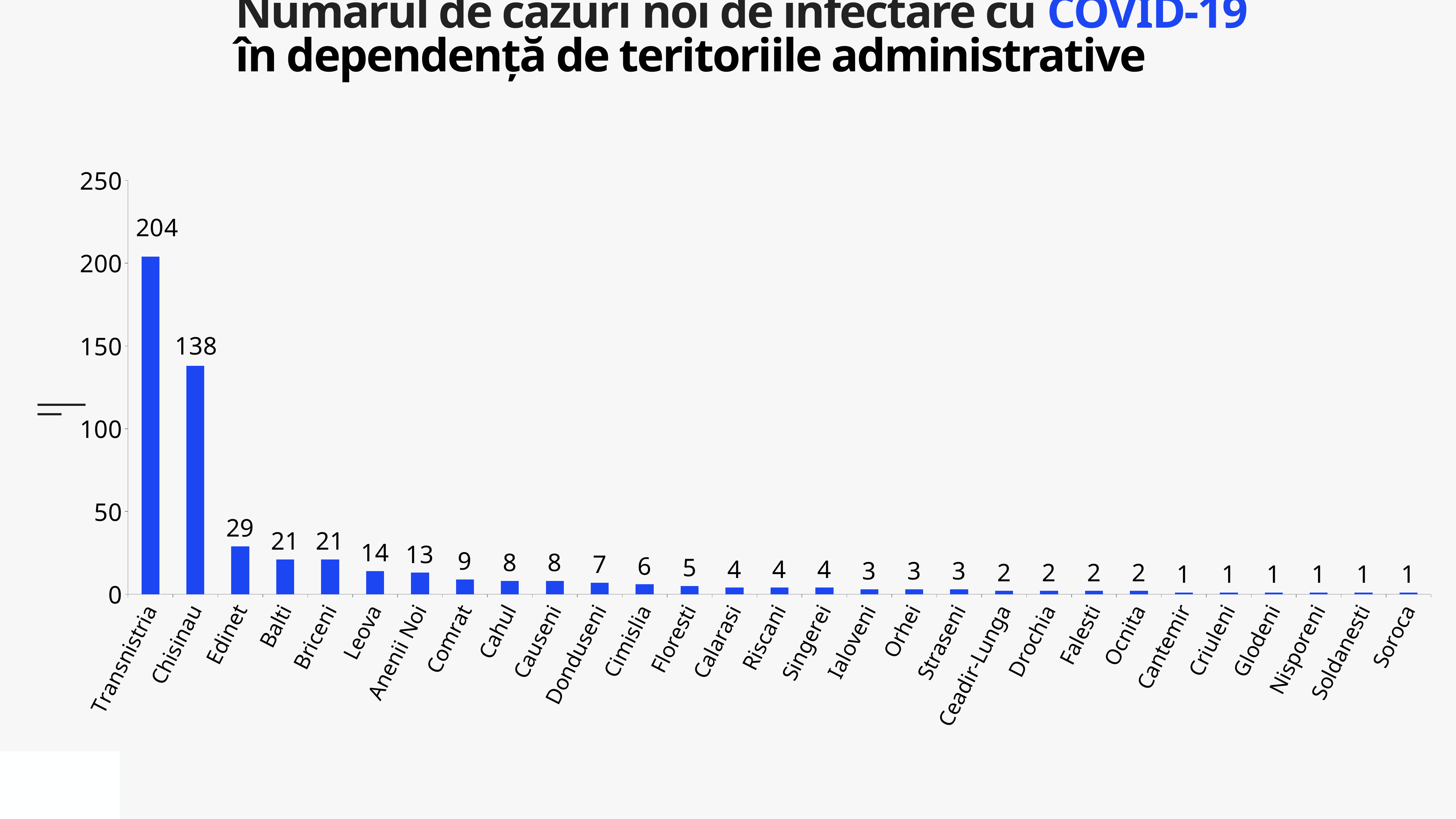
Which is larger, the value for Anenii Noi or the value for Comrat? Anenii Noi What is the difference between the values for Transnistria and Chisinau? 66 What is the value for Chisinau? 138 What is the value for Edinet? 29 How many categories are shown on the x axis? 29 What is the difference between the values for Edinet and Balti? 8 Is the value for Chisinau greater or less than 150? less Which category has the highest value? Transnistria What is the value for Leova? 14 Do the values rise or fall from left to right along the x axis? fall What kind of chart is shown on the slide? bar chart What is the value for Transnistria? 204